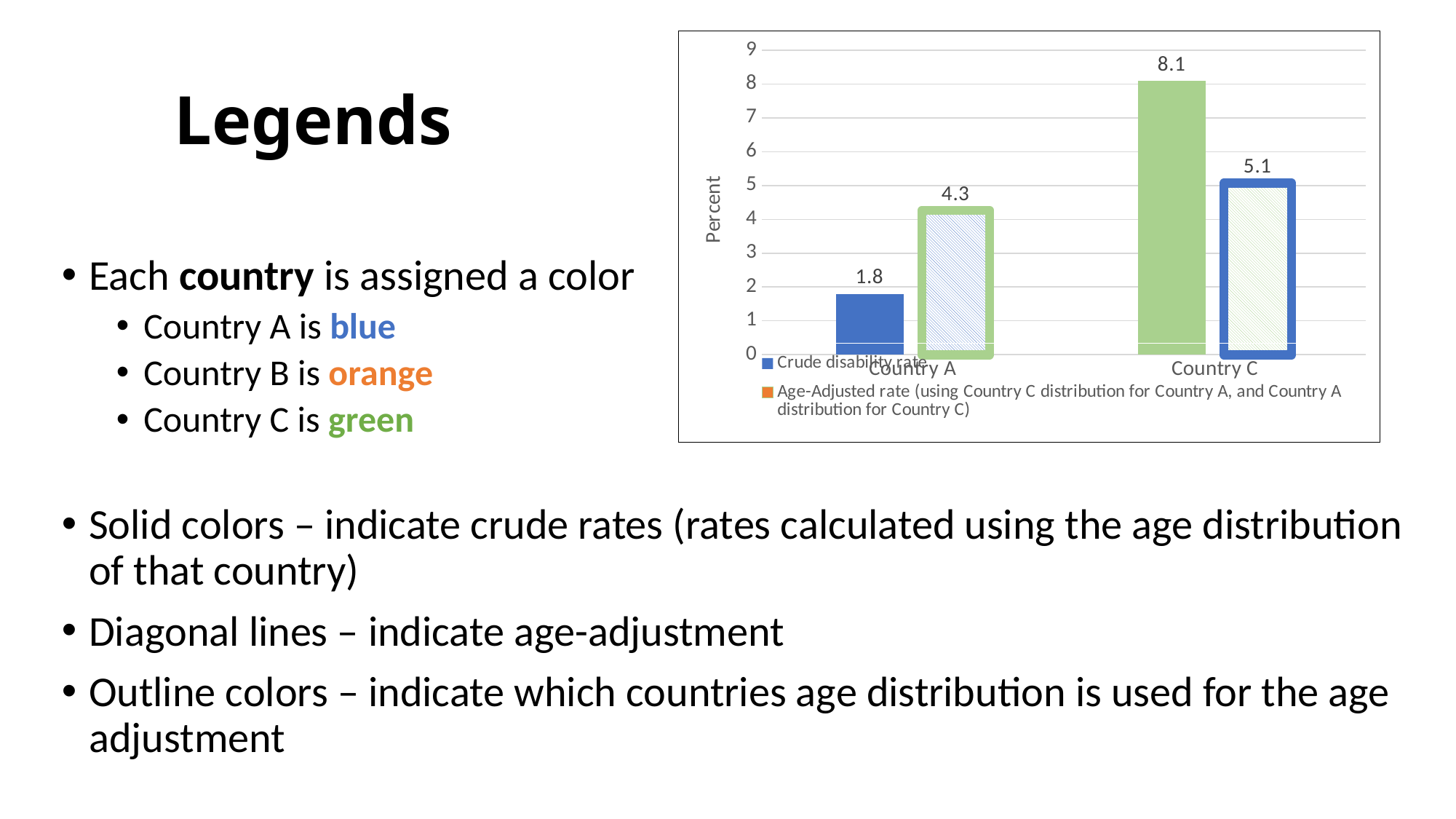
How many countries are shown on the x axis of the chart? 2 What is the crude disability rate for Country C? 8.1 Which is larger for Country A: the crude disability rate or the age-adjusted rate? Age-adjusted rate Which bar in the chart has the highest value? Crude disability rate for Country C Which bar in the chart has the lowest value? Crude disability rate for Country A What is the age-adjusted rate for Country C? 5.1 What is the crude disability rate for Country A? 1.8 What type of chart is shown on the slide? Bar chart How many series does the chart legend list? 2 What is the difference between the age-adjusted rate and the crude disability rate for Country A? 2.5 What is the difference between the crude disability rate and the age-adjusted rate for Country C? 3.0 What is the age-adjusted rate for Country A? 4.3